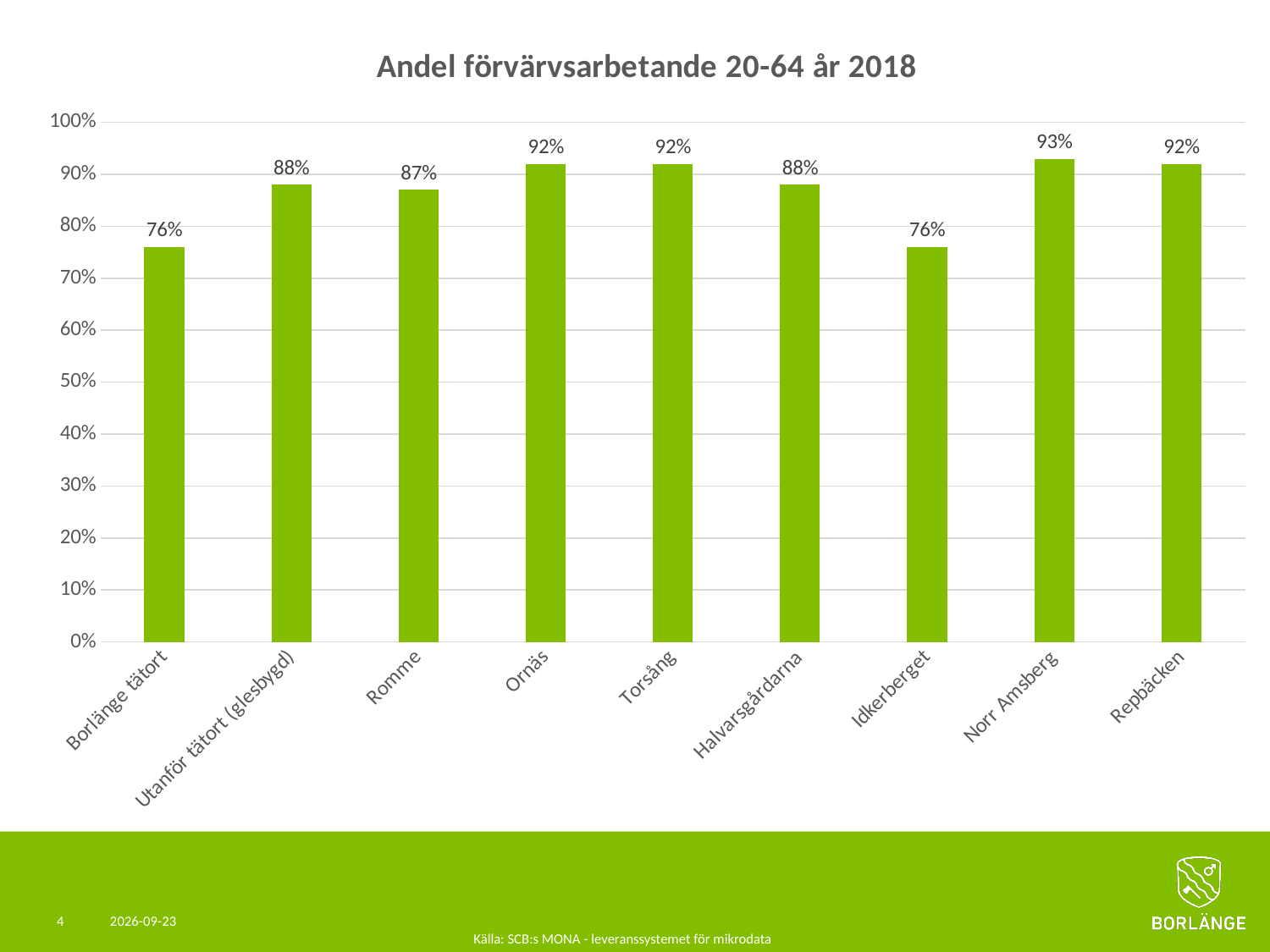
What kind of chart is shown on the slide? bar chart Which is larger, the value for Utanför tätort (glesbygd) or the value for Idkerberget? Utanför tätort (glesbygd) Which category has the highest value? Norr Amsberg What is the value for Romme? 87% What is the difference between the values for Norr Amsberg and Romme? 6% Is the value for Idkerberget greater or less than 80%? less What is the value for Borlänge tätort? 76% What is the difference between the values for Torsång and Borlänge tätort? 16% How many categories are shown on the x axis? 9 What is the title of the chart? Andel förvärvsarbetande 20-64 år 2018 What is the value for Halvarsgårdarna? 88% What is the value for Ornäs? 92%